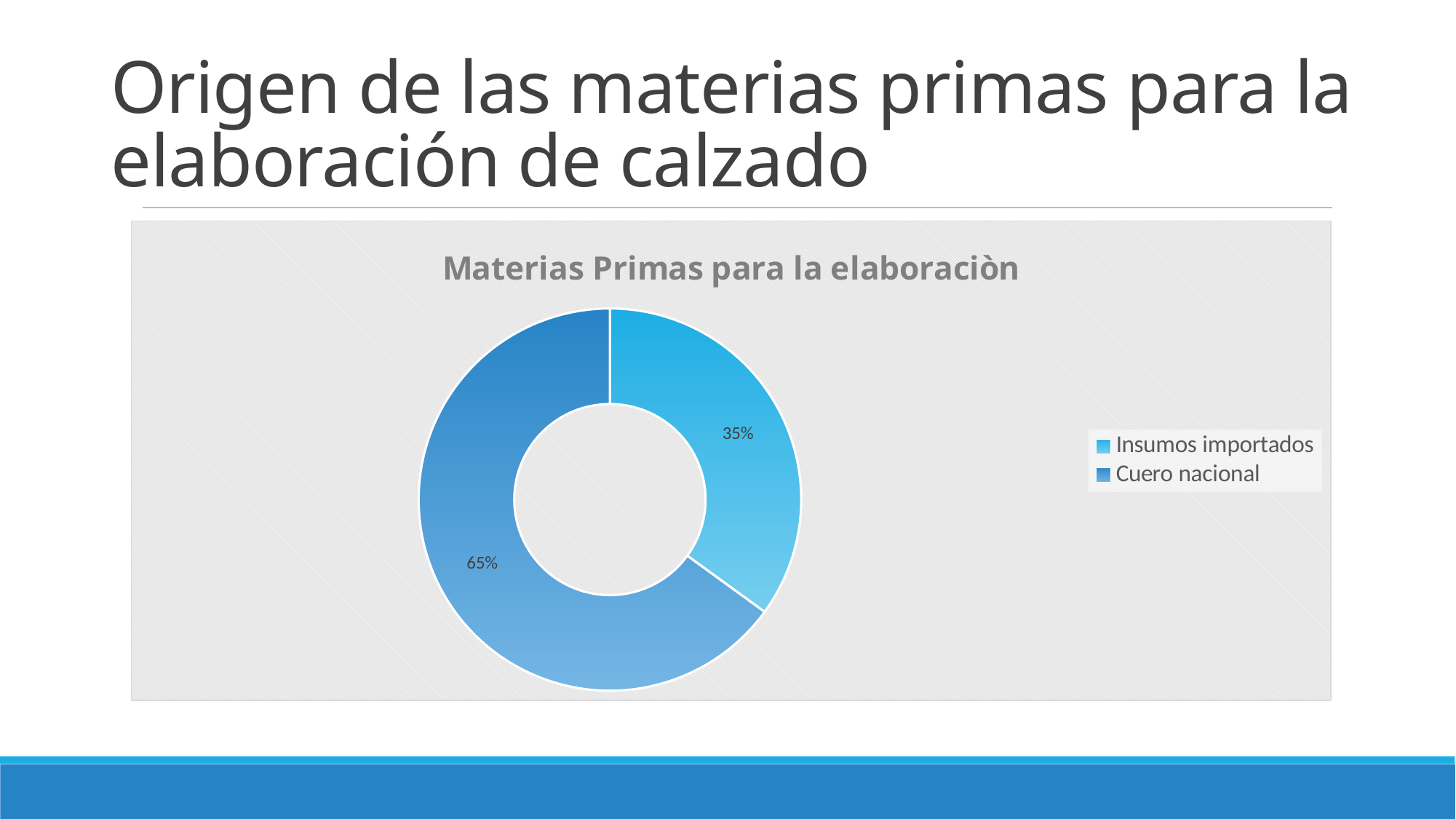
How many categories are shown in the chart? 2 What is the title of the chart? Materias Primas para la elaboraciòn Which legend entry is shown in the lighter blue colour? Insumos importados Which category has the largest share in the chart? Cuero nacional What share of the doughnut chart does Cuero nacional represent? 65% What is the difference in percentage points between Cuero nacional and Insumos importados? 30 Which is larger, the share for Insumos importados or the share for Cuero nacional? Cuero nacional What kind of chart is shown on the slide? Doughnut (pie) chart How many entries does the legend list? 2 Which category has the smallest share in the chart? Insumos importados What share of the doughnut chart does Insumos importados represent? 35%